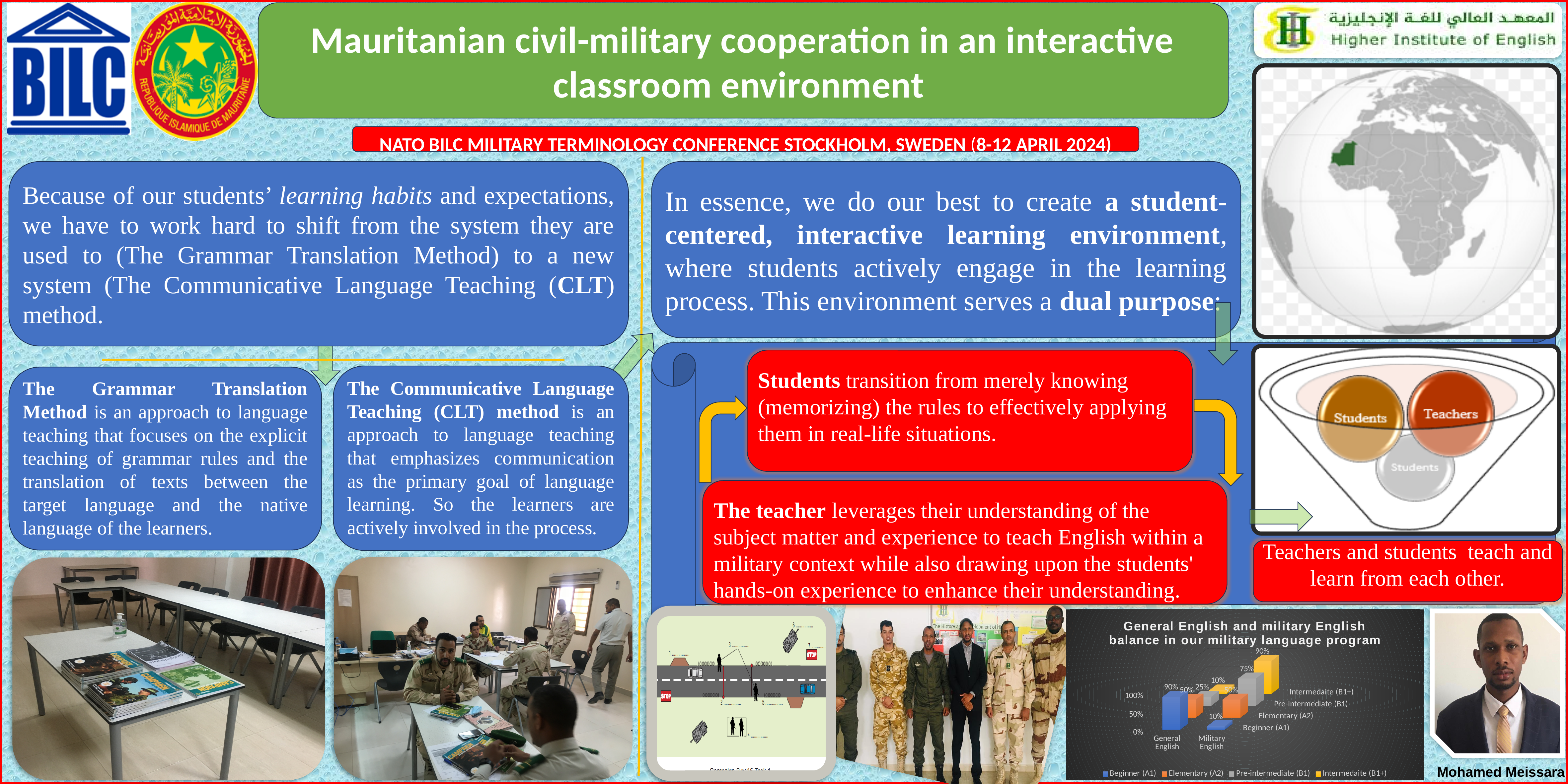
What kind of chart is shown at the bottom right of the slide? bar chart What is the title of the chart at the bottom right of the slide? General English and military English balance in our military language program In the chart, what is the value for Beginner (A1) in General English? 90% Which two categories are shown on the x axis of the chart? General English and Military English In the chart, what is the value for Beginner (A1) in Military English? 10% In the chart, what is the value for Pre-intermediate (B1) in Military English? 75% How many categories are shown on the x axis of the chart? 2 In the chart, which series has the highest value for Military English? Intermedaite (B1+) In the chart, which is larger for Beginner (A1): General English or Military English? General English How many series does the legend of the chart list? 4 In the chart, what is the value for Intermedaite (B1+) in Military English? 90% In the chart, what is the difference between the Beginner (A1) values for General English and Military English? 80%